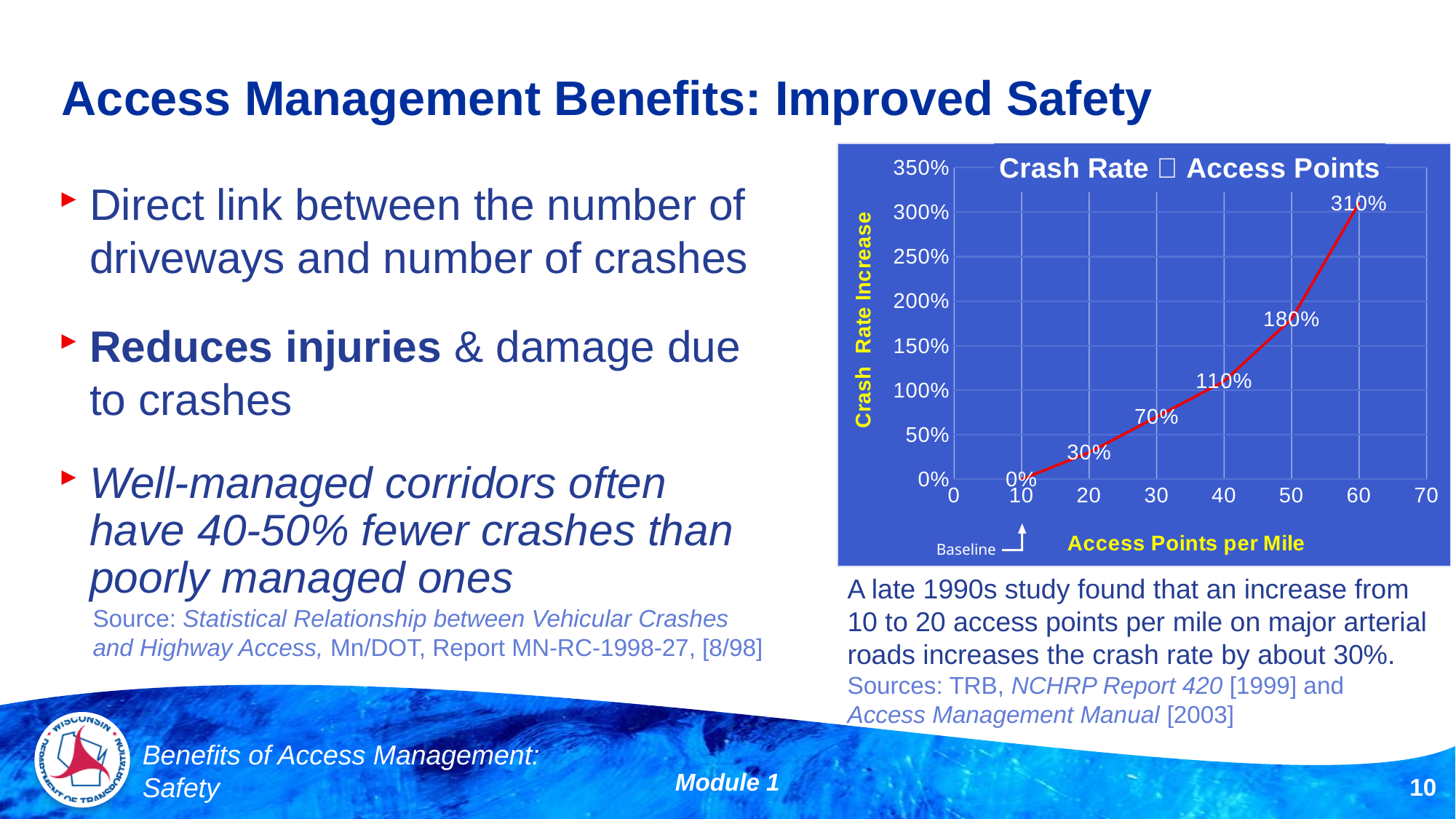
At which number of access points per mile is the crash rate increase lowest? 10 What is the label of the x axis of the chart? Access Points per Mile What is the crash rate increase at 40 access points per mile? 110% At which number of access points per mile is the crash rate increase highest? 60 Does the crash rate increase rise or fall as access points per mile increase? rise How many data points are plotted on the chart? 6 What is the crash rate increase at 60 access points per mile? 310% What type of chart is shown on the slide? line chart Which has a larger crash rate increase: 30 or 50 access points per mile? 50 What is the crash rate increase at 20 access points per mile? 30% What is the crash rate increase at 10 access points per mile? 0% What is the difference in crash rate increase between 50 and 30 access points per mile? 110%